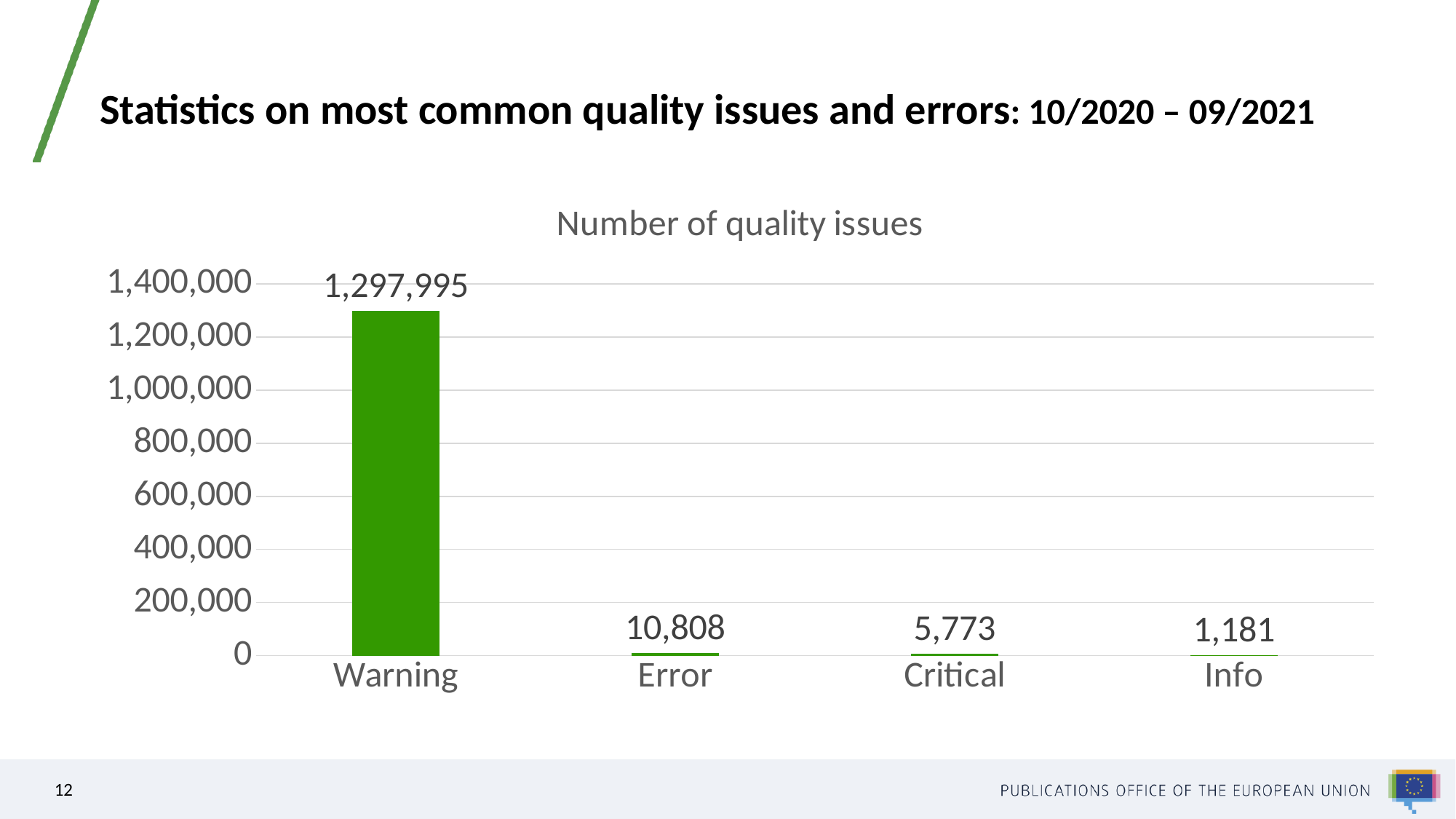
What is the number of quality issues for Error? 10,808 How many categories are shown in the chart? 4 What is the difference between the number of quality issues for Error and for Critical? 5,035 What is the number of quality issues for Critical? 5,773 What is the difference between the number of quality issues for Critical and for Info? 4,592 Which category has the lowest number of quality issues? Info What type of chart is shown on the slide? Bar chart What is the number of quality issues for Warning? 1,297,995 What is the number of quality issues for Info? 1,181 Which has more quality issues, Error or Critical? Error Which category has the highest number of quality issues? Warning Is the value for Warning greater or less than 1,200,000? greater